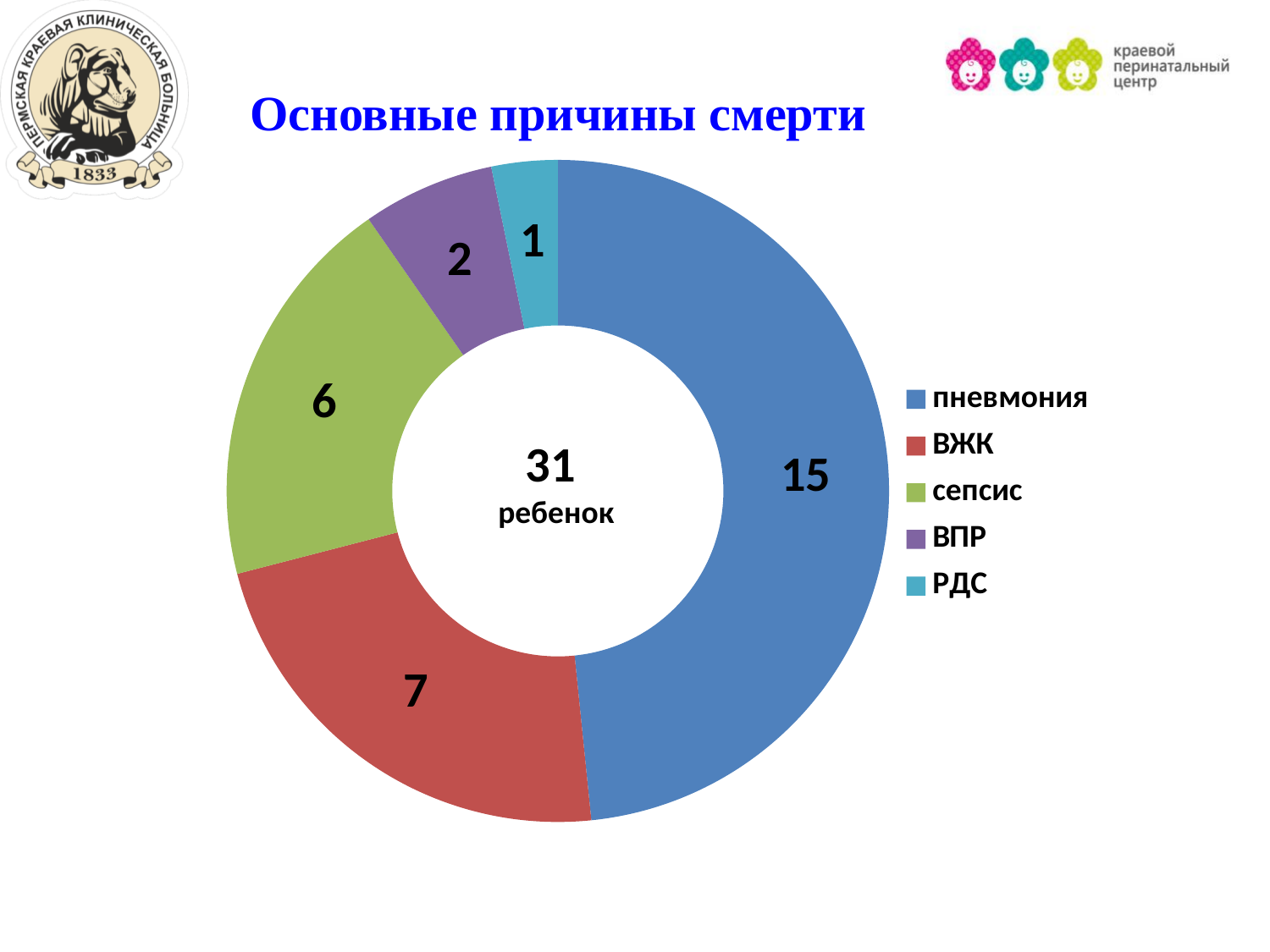
What is the difference between the values for пневмония and ВЖК? 8 How many categories does the chart show? 5 Which cause of death has the lowest value? РДС What is the value for ВЖК? 7 What kind of chart is shown on the slide? doughnut (pie) chart Which cause of death has the highest value? пневмония Which is larger, the value for сепсис or the value for ВПР? сепсис What total number is shown in the centre of the chart? 31 ребенок What is the value for сепсис? 6 What is the value for пневмония? 15 What is the value for РДС? 1 What is the value for ВПР? 2